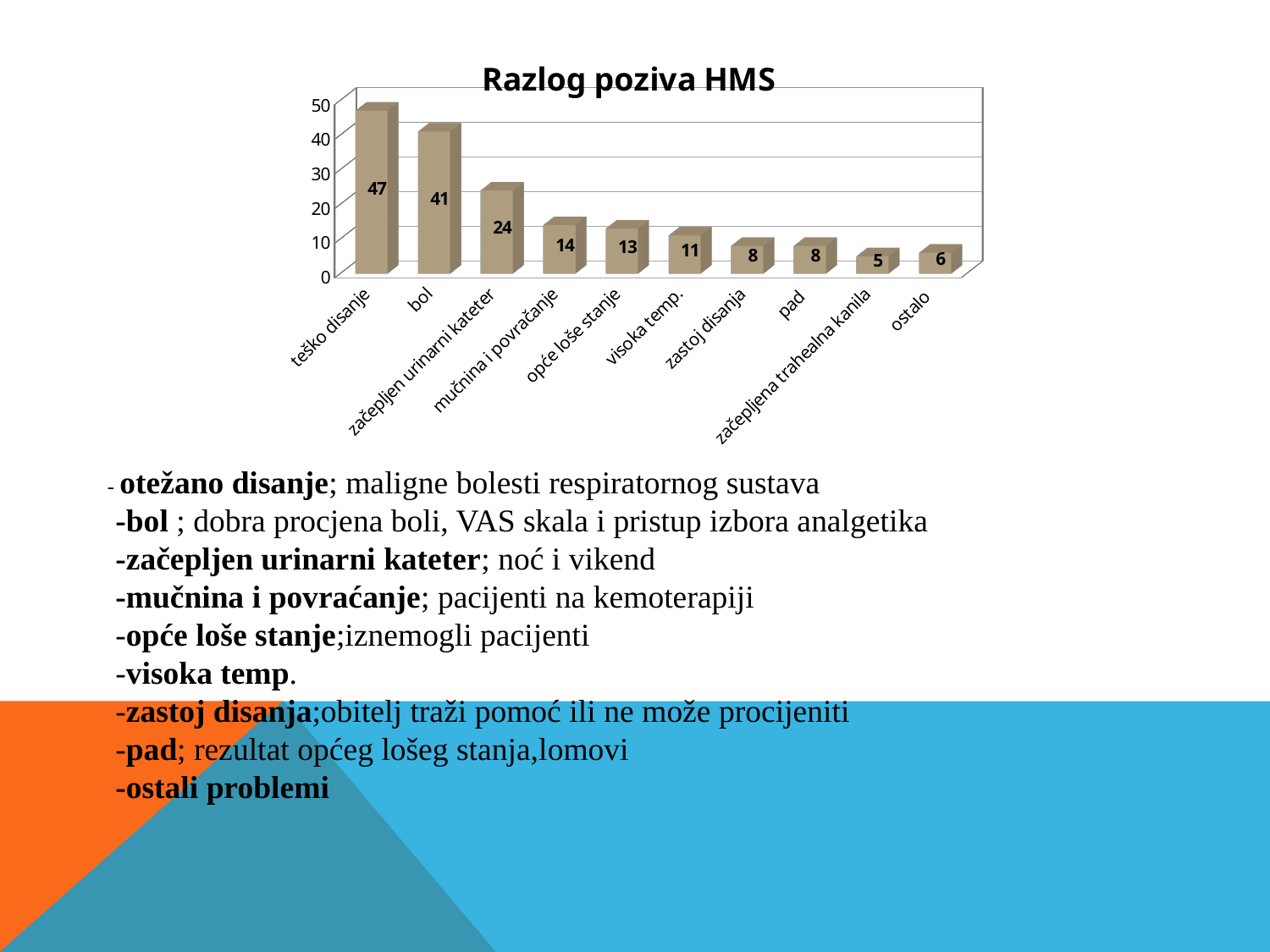
How many categories are shown in the chart? 10 Which is larger, the value for 'mučnina i povraćanje' or 'opće loše stanje'? mučnina i povraćanje What is the value for 'začepljen urinarni kateter'? 24 What kind of chart is shown on the slide? bar chart Which category has the highest value? teško disanje Do the values generally rise or fall from left to right along the x axis? fall What is the value for 'ostalo'? 6 What is the difference between the values for 'teško disanje' and 'bol'? 6 Is the value for 'visoka temp.' greater or less than 20? less Which category has the lowest value? začepljena trahealna kanila What is the title of the chart? Razlog poziva HMS What is the value for 'bol' in the chart? 41